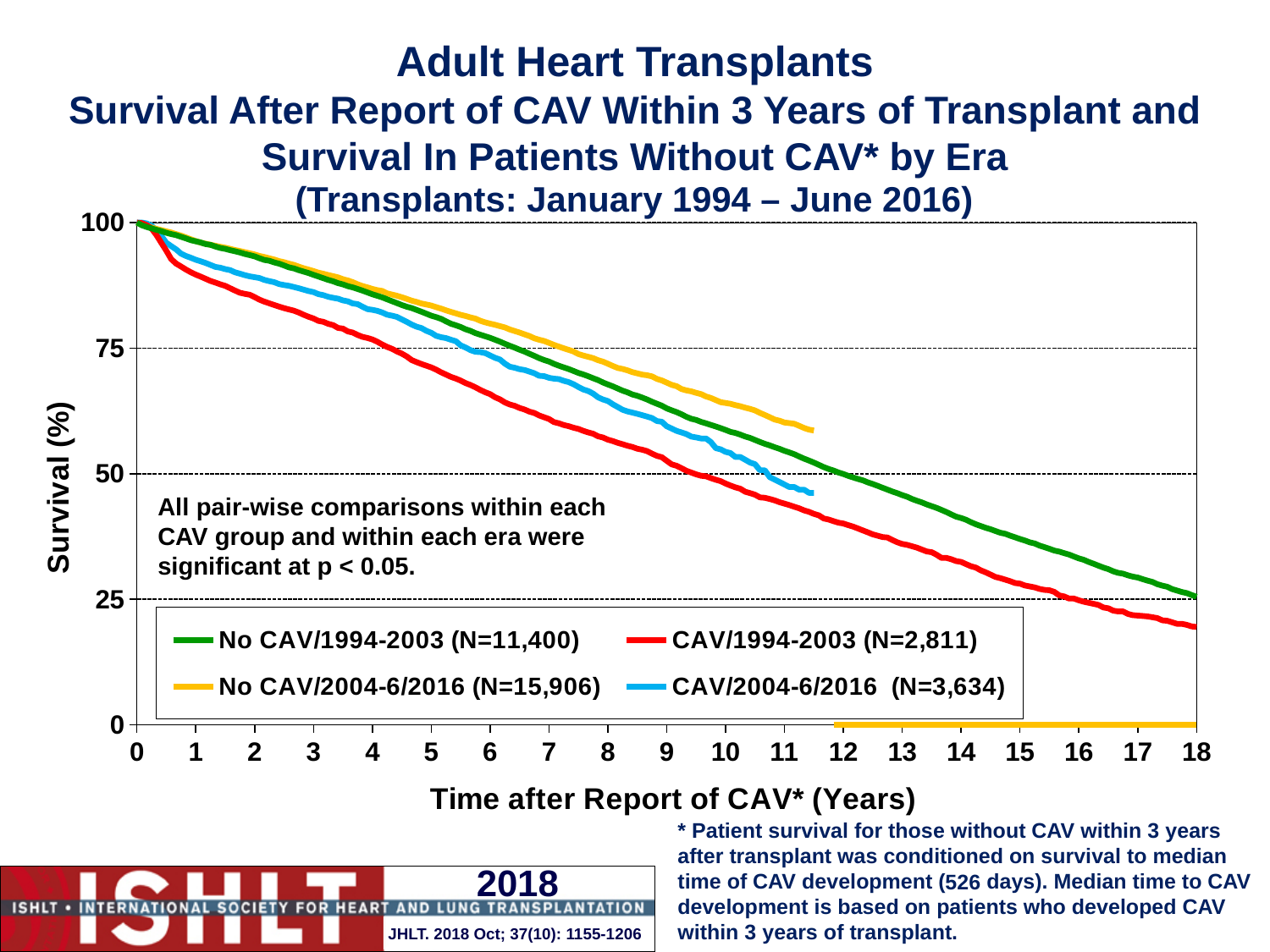
Is the survival value for CAV/1994-2003 at 18 years greater or less than 25? less What is the survival value for all four groups at time 0? 100 Is the survival value for No CAV/1994-2003 at 10 years greater or less than 50? greater Which series has the highest survival curve over the years it is plotted? No CAV/2004-6/2016 (N=15,906) Which series has the lowest survival curve across the chart? CAV/1994-2003 (N=2,811) How many series does the legend list? 4 At 10 years, which series has the higher survival: No CAV/2004-6/2016 or CAV/1994-2003? No CAV/2004-6/2016 What is the label of the y axis? Survival (%) Is the survival value for No CAV/2004-6/2016 at 5 years greater or less than 75? greater What kind of chart is shown on the slide? line chart Do the survival curves rise or fall as time after report of CAV increases? fall